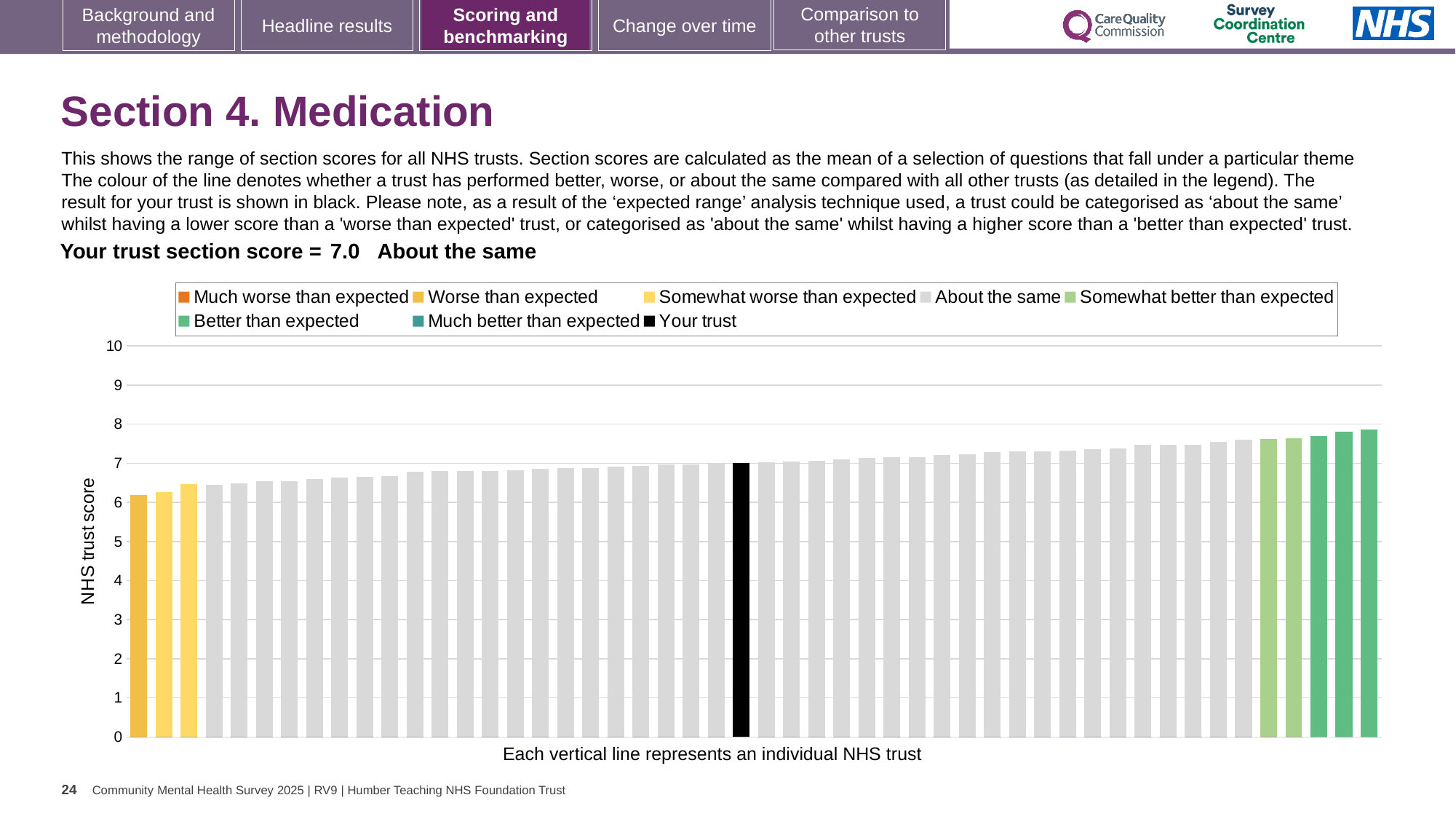
Which category does your trust fall into according to the slide? About the same What colour is the bar representing your trust? black How many bars are coloured yellow (worse than expected categories) in the chart? 3 Do the bar values rise or fall from left to right along the x axis? rise What is the section score for your trust shown on the slide? 7.0 Is the value of the lowest bar in the chart greater or less than 6? greater How many entries does the chart legend list? 8 What is the label on the y axis of the chart? NHS trust score Is the value of the black 'Your trust' bar greater or less than 5? greater Is the value of the lowest bar in the chart greater or less than 7? less What kind of chart is shown on the slide? bar chart